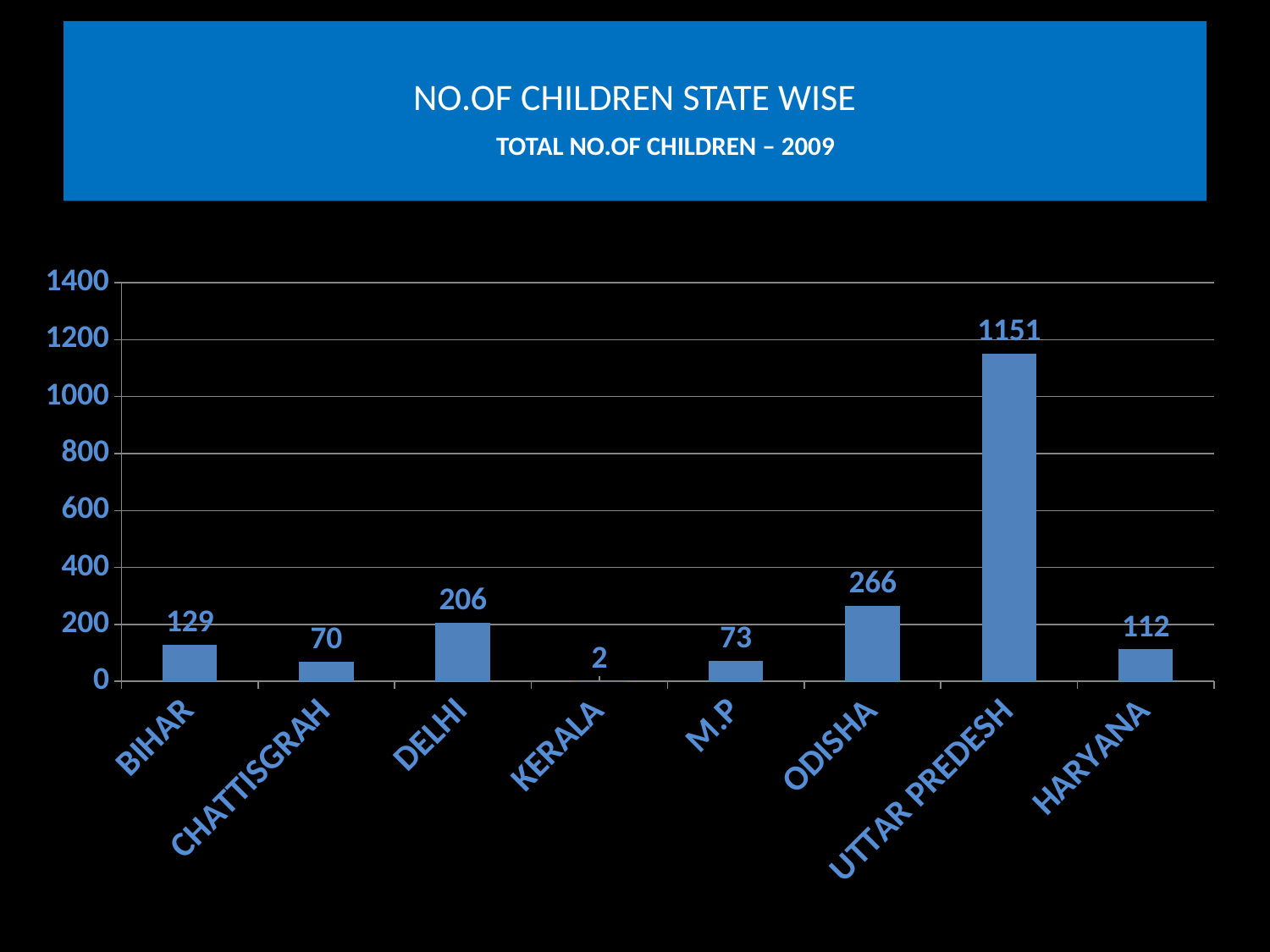
Which is larger, the value for CHATTISGRAH or the value for M.P? M.P How many states are shown on the x axis? 8 Is the value for ODISHA greater or less than 200? greater What is the value for DELHI? 206 Which state has the lowest number of children? KERALA What is the value for UTTAR PREDESH? 1151 What is the difference between the values for ODISHA and BIHAR? 137 What kind of chart is shown on the slide? bar chart Which state has the highest number of children? UTTAR PREDESH What is the value for KERALA? 2 What is the value for HARYANA? 112